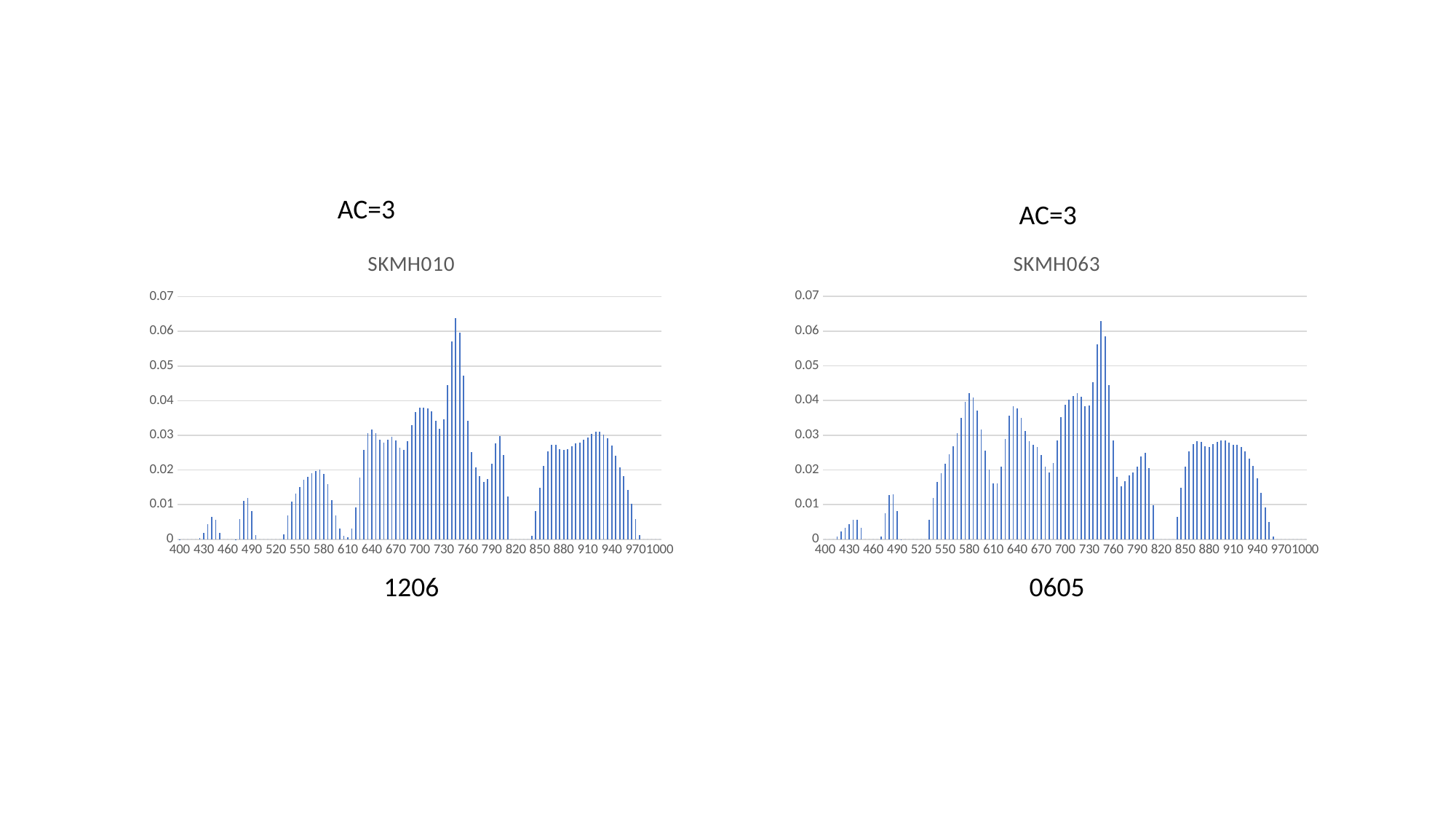
In the SKMH063 chart, between which two labelled x-axis ticks does the tallest bar fall? 730 and 760 In the SKMH063 chart, are the bars around 880 greater or less than 0.04? less In the SKMH010 chart, is any bar greater or less than 0.07? less What is the first and last value labelled on the x axis of the SKMH063 chart? 400 and 1000 What is the highest value labelled on the y axis of the SKMH063 chart? 0.07 What kind of chart is the SKMH010 chart on the left? bar chart In the SKMH010 chart, are the bars around 550 greater or less than 0.03? less What is the title of the chart on the right? SKMH063 In the SKMH010 chart, between which two labelled x-axis ticks does the tallest bar fall? 730 and 760 How many labelled tick values are on the y axis of the SKMH010 chart? 8